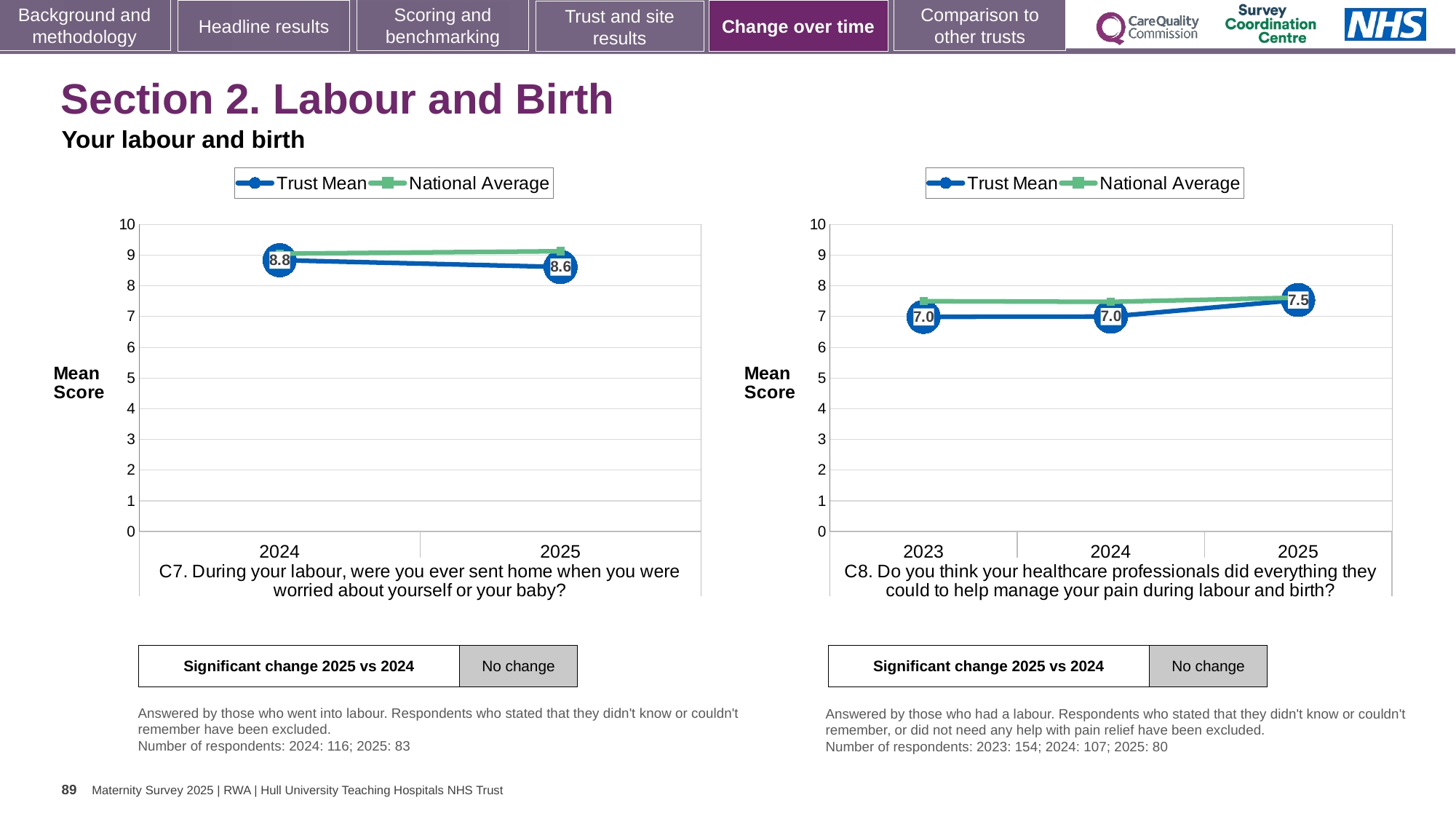
In the right chart (C8), what is the Trust Mean score for 2025? 7.5 In the right chart (C8), what is the difference between the Trust Mean in 2025 and in 2024? 0.5 How many series does the legend of the left chart (C7) list? 2 In the left chart (C7), does the Trust Mean rise or fall from 2024 to 2025? fall How many years are shown on the x axis of the right chart (C8)? 3 In the right chart (C8), what is the Trust Mean score for 2023? 7.0 In the left chart (C7), by how much did the Trust Mean change from 2024 to 2025? 0.2 In the right chart (C8), is the National Average for 2023 greater or less than 7? greater What type of chart is the right chart (C8)? line chart In the right chart (C8), which year has the highest Trust Mean score? 2025 In the left chart (C7), what is the Trust Mean score for 2024? 8.8 In the left chart (C7), what is the Trust Mean score for 2025? 8.6